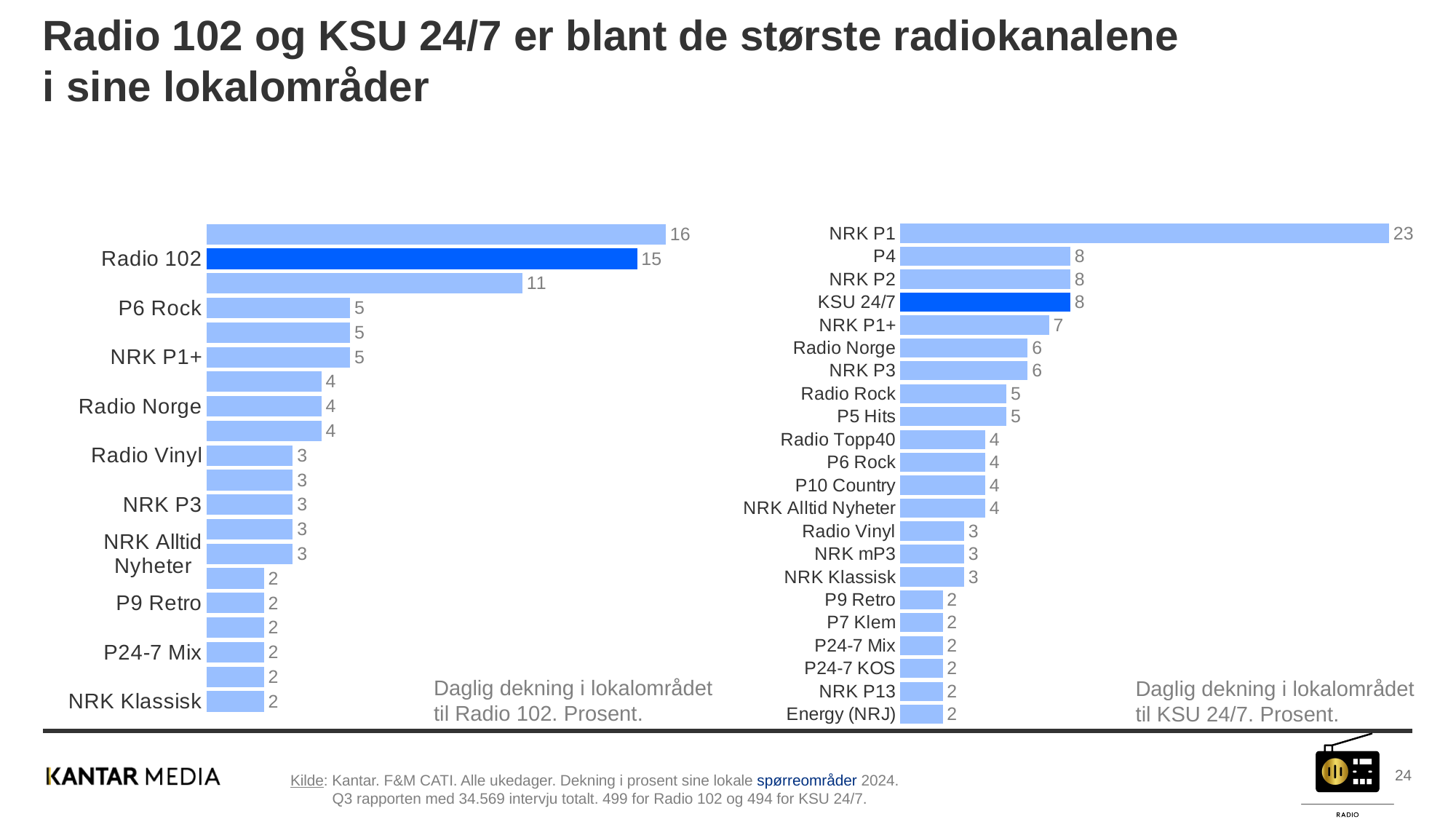
In the left chart (Daglig dekning i lokalområdet til Radio 102), what is the value for Radio 102? 15 In the right chart (KSU 24/7 local area), what is the value for Energy (NRJ)? 2 In the left chart (Radio 102 local area), what is the value for P6 Rock? 5 In the right chart (KSU 24/7 local area), what is the difference between NRK P1 and KSU 24/7? 15 In the right chart (Daglig dekning i lokalområdet til KSU 24/7), what is the value for NRK P1? 23 In the left chart (Radio 102 local area), which is larger: NRK P1+ or Radio Vinyl? NRK P1+ In the right chart (KSU 24/7 local area), which is larger: NRK P1+ or Radio Norge? NRK P1+ How many bars are plotted in the right chart (KSU 24/7 local area)? 22 What type of chart is used on this slide? Bar chart In the left chart (Radio 102 local area), what is the difference between Radio 102 and NRK Klassisk? 13 In the right chart (KSU 24/7 local area), what is the value for KSU 24/7? 8 In the right chart (KSU 24/7 local area), which channel has the highest value? NRK P1